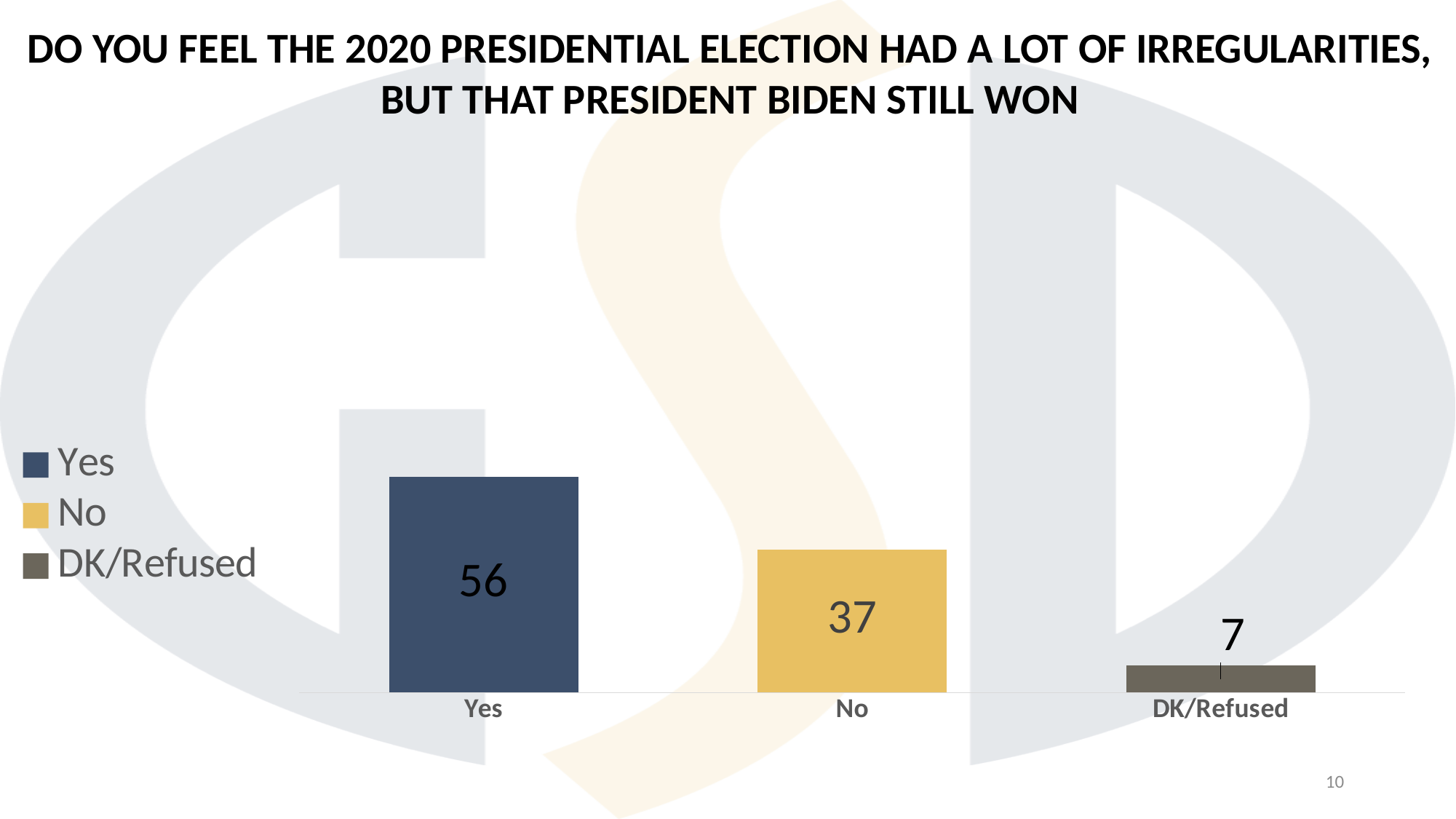
What is the difference between the values for No and DK/Refused? 30 Which category has the highest value? Yes What is the value for DK/Refused? 7 What is the value for No? 37 Which is larger, the value for Yes or the value for No? Yes What colour is the bar for No? yellow How many categories are shown on the x axis? 3 What is the difference between the values for Yes and No? 19 How many entries does the legend list? 3 What kind of chart is shown on the slide? bar chart Which category has the lowest value? DK/Refused What is the value for Yes? 56